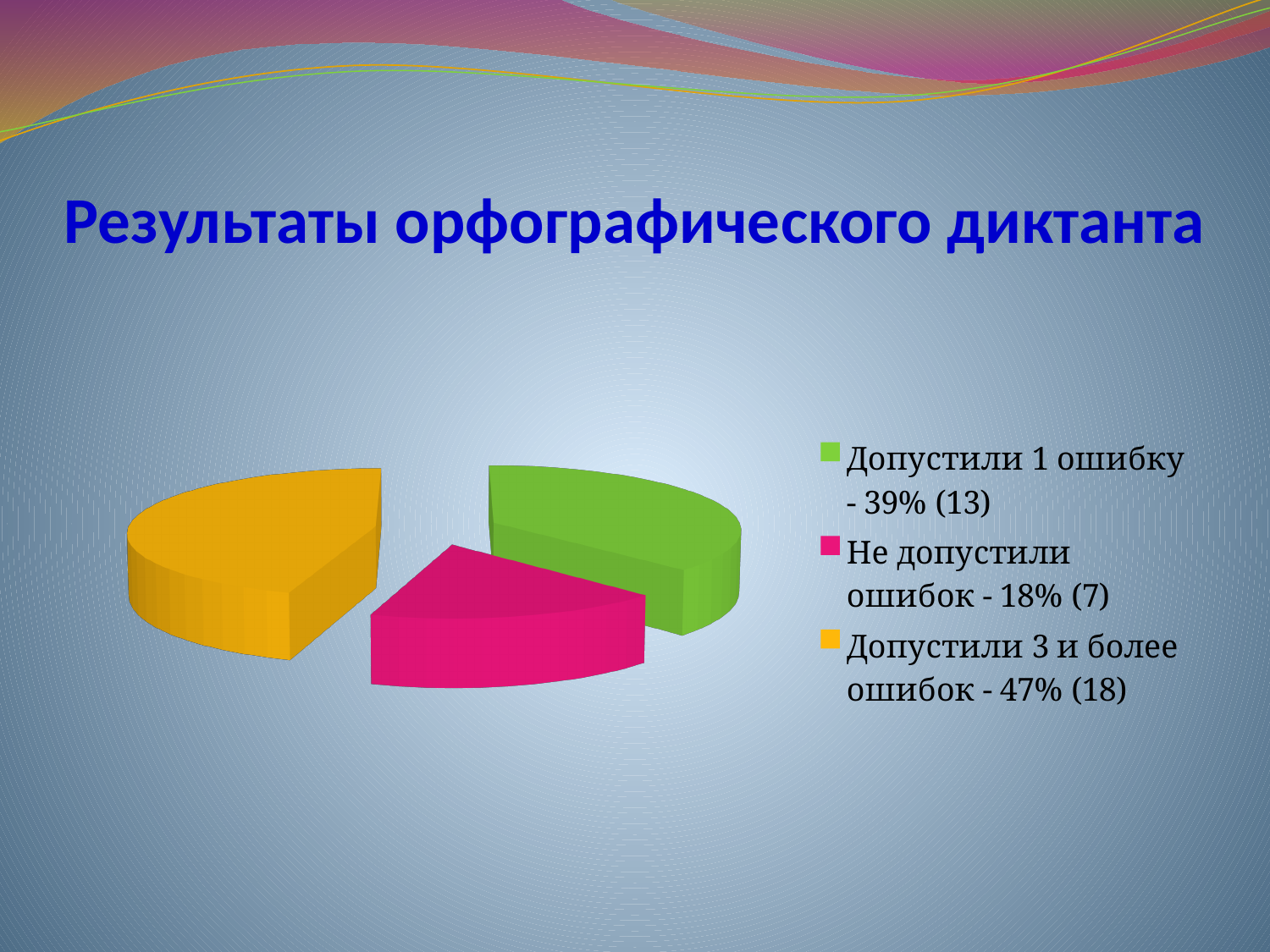
What is the title of the chart on the slide? Результаты орфографического диктанта What percentage share is shown for "Допустили 1 ошибку"? 39% Which category has the smallest share of the pie? Не допустили ошибок What is the difference in percentage points between "Допустили 3 и более ошибок" and "Допустили 1 ошибку"? 8 What percentage share is shown for "Не допустили ошибок"? 18% What percentage share is shown for "Допустили 3 и более ошибок"? 47% Which category has the largest share of the pie? Допустили 3 и более ошибок How many students are listed for "Допустили 3 и более ошибок"? 18 Which colour represents "Не допустили ошибок" in the pie chart? Pink Which is larger: the share for "Допустили 1 ошибку" or the share for "Не допустили ошибок"? Допустили 1 ошибку How many slices does the pie chart have? 3 What kind of chart is shown on the slide? Pie chart